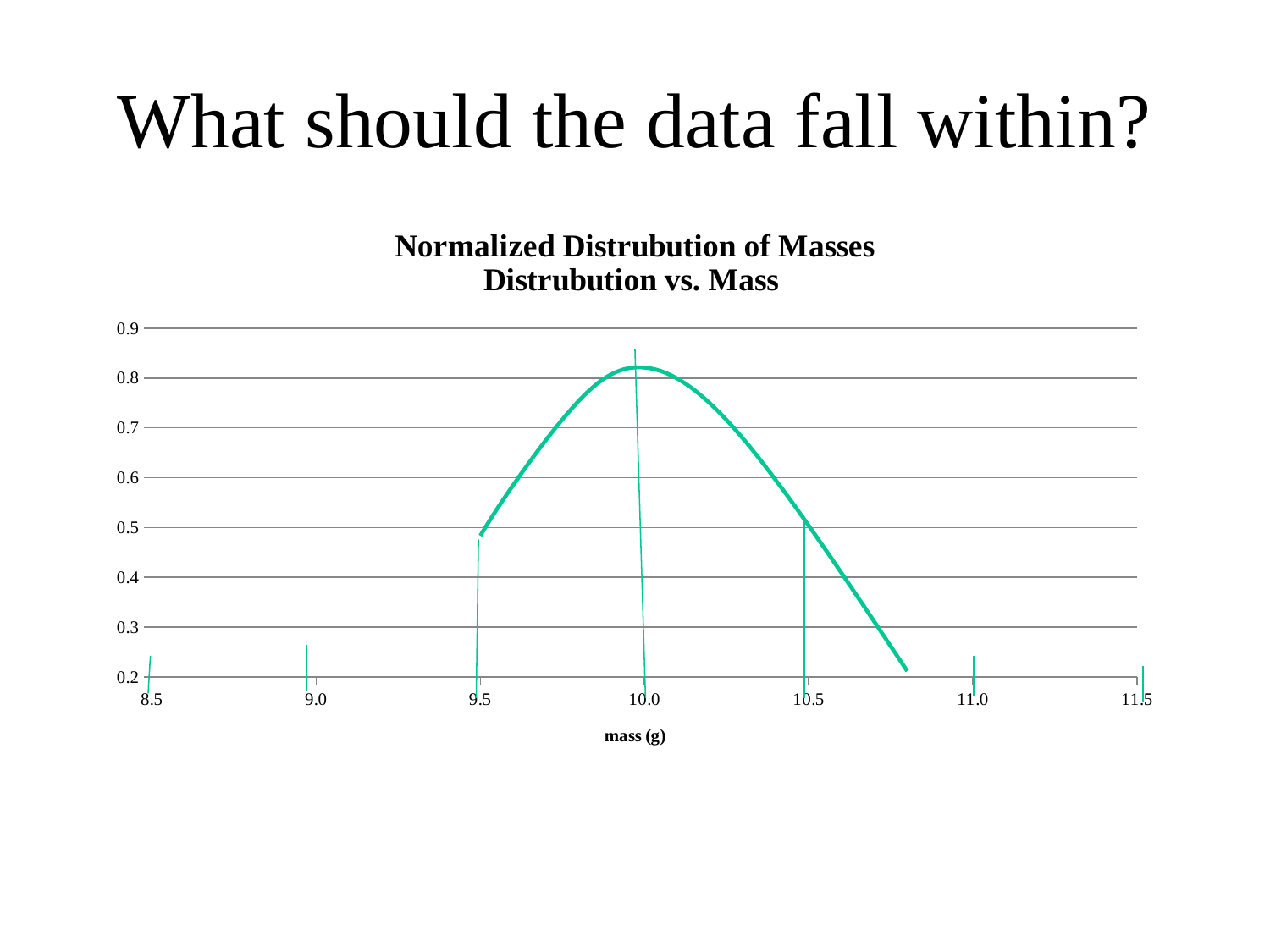
Does the curve rise or fall as mass increases from 9.5 g to 10.0 g? rise What kind of chart is shown on the slide? line chart Is the value of the curve at a mass of 9.5 g greater or less than 0.6? less Is the value of the curve at 10.0 g larger or smaller than the value at 9.5 g? larger What is the label on the x axis of the chart? mass (g) What is the title of the chart? Normalized Distrubution of Masses Distrubution vs. Mass How many labelled tick values are shown on the x axis? 7 Is the value of the curve at a mass of 10.5 g greater or less than 0.4? greater Does the curve rise or fall as mass increases from 10.0 g to 10.5 g? fall At approximately which x-axis tick value does the curve reach its highest point? 10.0 Is the value of the curve at a mass of 10.5 g greater or less than 0.6? less